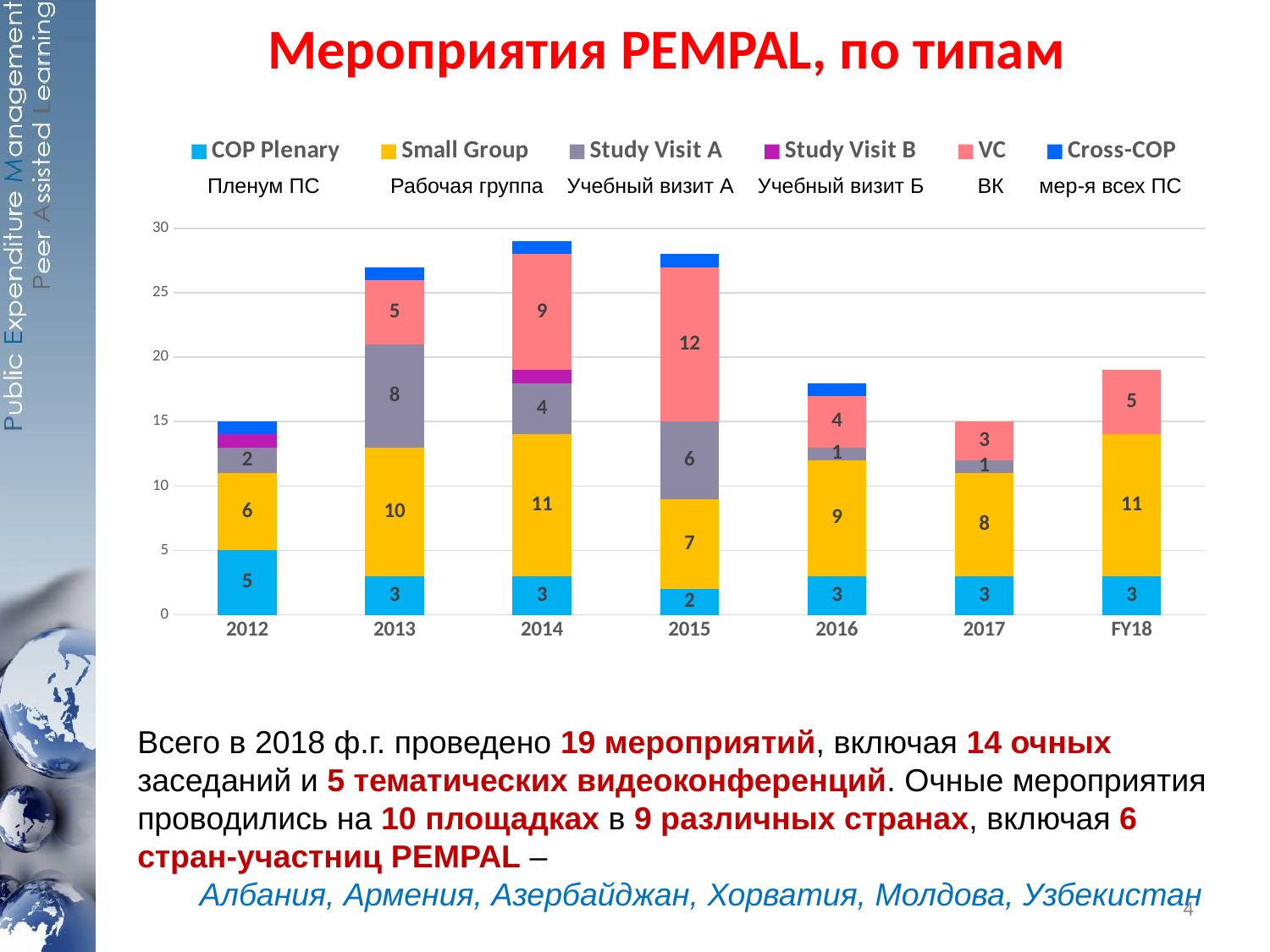
What is the difference between the Small Group values for 2014 and 2015? 4 What is the COP Plenary value for 2012? 5 In which year is the VC value highest? 2015 Is the total height of the 2014 bar greater or less than 25? greater In which year is the COP Plenary value lowest? 2015 Which year has the larger Study Visit A value, 2013 or 2015? 2013 What is the total of the stacked bar for FY18? 19 How many years (categories) are shown on the x axis? 7 What is the VC value for 2015? 12 What is the Small Group value for 2013? 10 How many series does the legend list? 6 What kind of chart is shown on the slide? bar chart